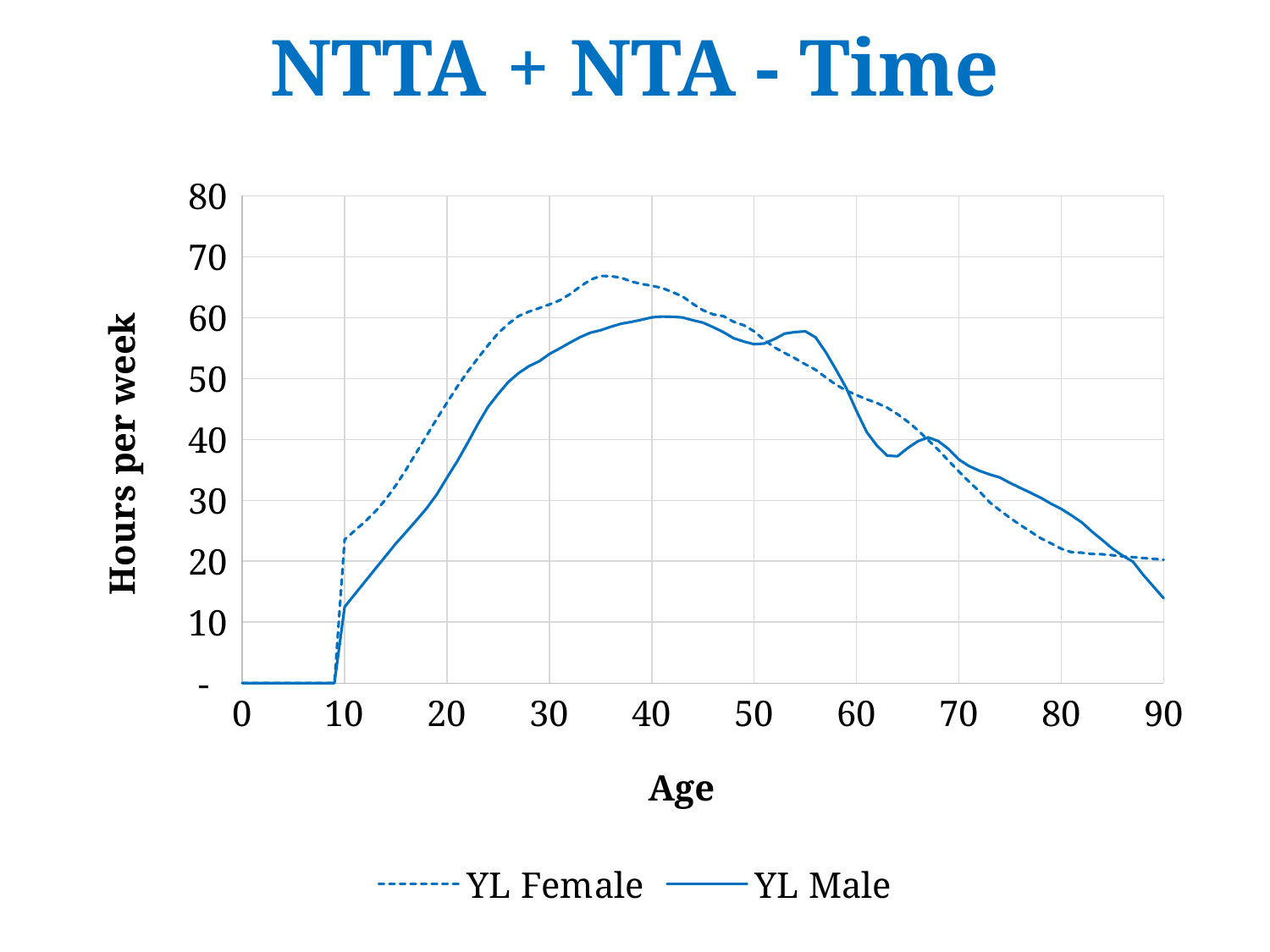
At age 30, which series has the higher value, YL Female or YL Male? YL Female Is the value for YL Male at age 90 greater or less than 20? less What is the title of the chart? NTTA + NTA - Time How many series does the legend list? 2 Is the value for YL Female at age 10 greater or less than 20? greater Do the values for YL Male rise or fall between age 50 and age 90? Fall Is the value for YL Female at age 35 greater or less than 60? greater What kind of chart is shown on the slide? Line chart What is the label of the vertical axis? Hours per week At age 75, which series has the higher value, YL Female or YL Male? YL Male Which series reaches the higher peak value? YL Female